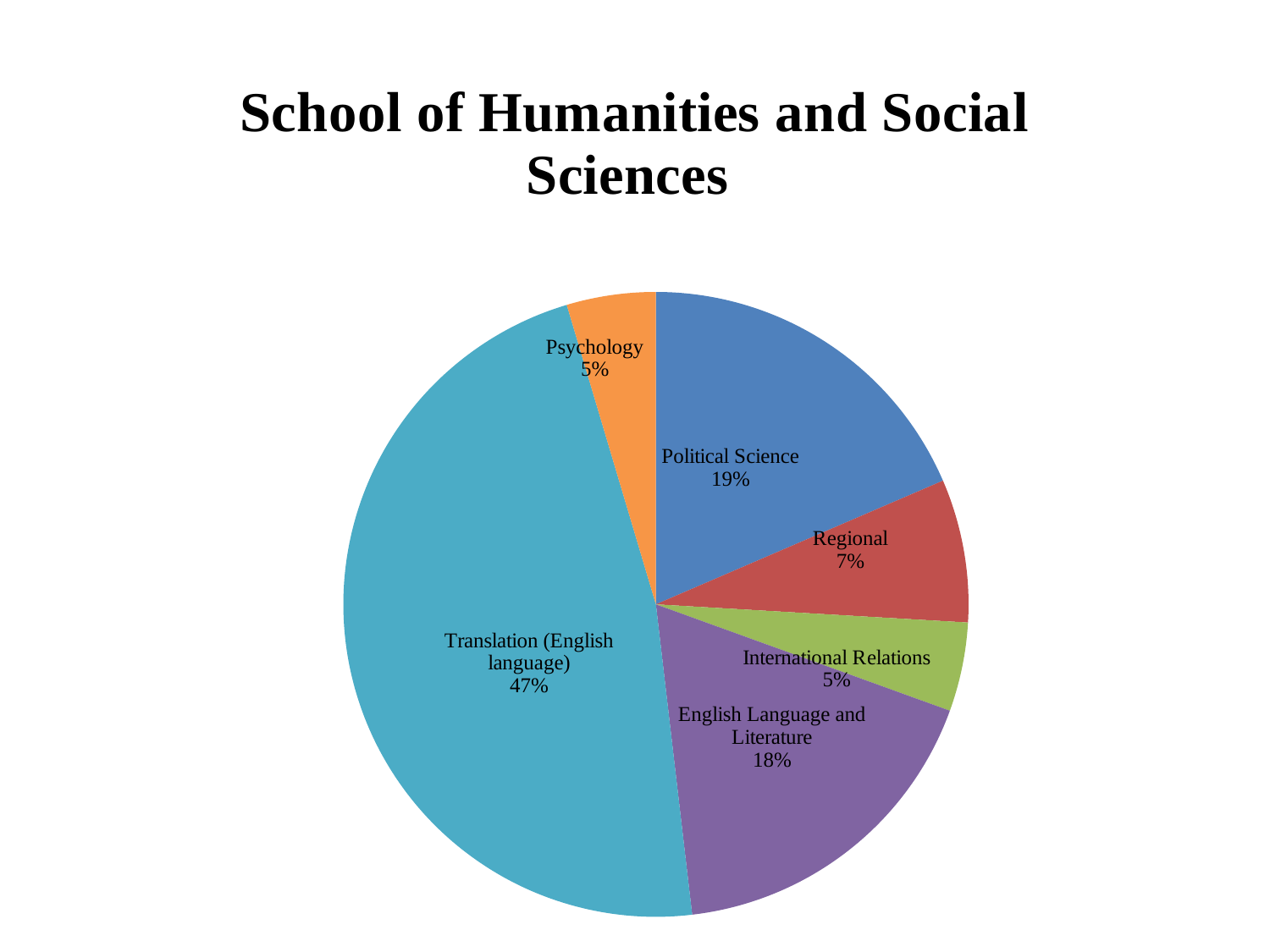
What percentage is shown for Political Science? 19% Which category has the largest slice of the pie? Translation (English language) What kind of chart is shown on the slide? pie chart What is the difference in percentage points between Translation (English language) and English Language and Literature? 29 What share of the pie does Translation (English language) have? 47% What is the title of the chart on the slide? School of Humanities and Social Sciences What percentage is shown for Psychology? 5% How many slices does the pie chart have? 6 What percentage is shown for Regional? 7% Which is larger, the slice for Political Science or the slice for English Language and Literature? Political Science What percentage is shown for English Language and Literature? 18% What is the difference in percentage points between Political Science and Regional? 12